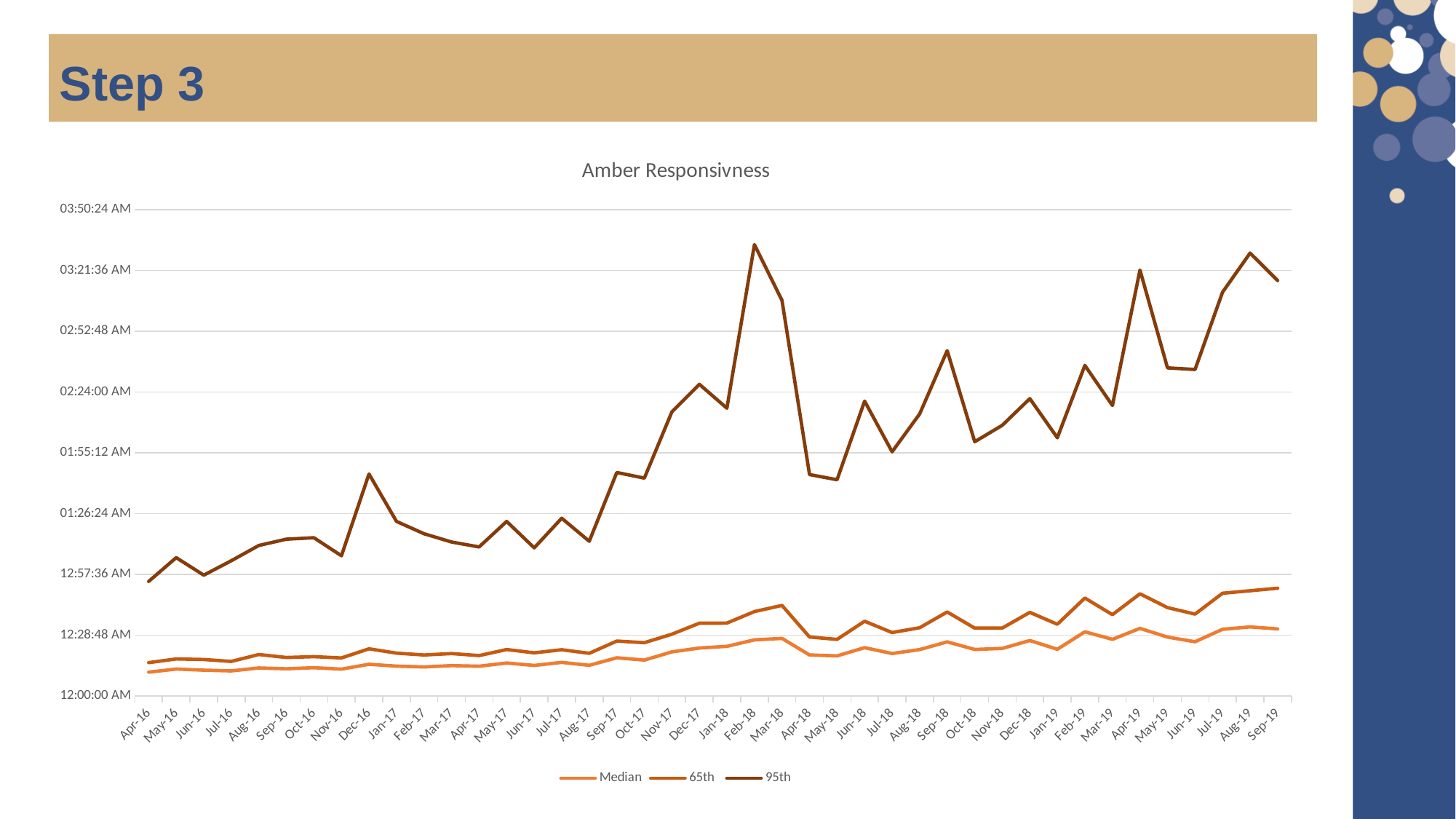
Which series has the larger value in Sep-19, the 95th or the Median? 95th Is the value of the 65th series in Sep-19 greater or less than 12:28:48 AM? greater How many series does the legend list? 3 What are the names of the series in the legend? Median, 65th, 95th In which month does the 95th series reach its lowest value? Apr-16 In which month does the 95th series reach its highest value? Feb-18 Is the value of the 95th series in Feb-18 greater or less than 03:21:36 AM? greater What is the title of the chart? Amber Responsivness Does the Median series generally rise or fall from Apr-16 to Sep-19? rise Is the value of the 95th series in Apr-16 greater or less than 01:26:24 AM? less How many monthly data points are plotted along the x axis? 42 What type of chart is shown on the slide? line chart